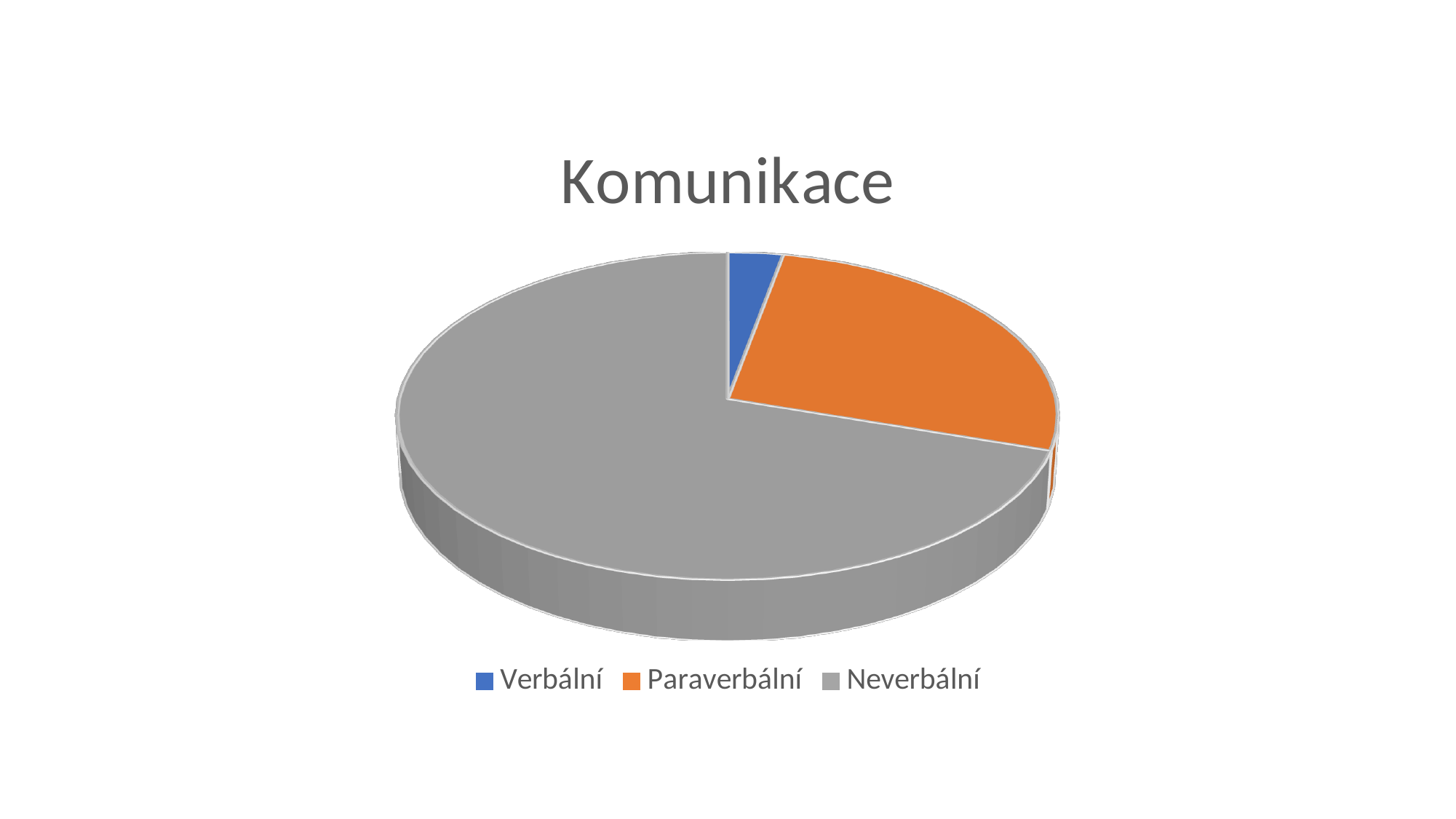
How many slices does the pie chart have? 3 Which category has the smallest slice of the pie? Verbální How many entries does the legend list? 3 Does the Neverbální slice take up more or less than half of the pie? more Which slice is larger, Paraverbální or Verbální? Paraverbální What kind of chart is shown on the slide? pie chart Which category has the largest slice of the pie? Neverbální What is the title of the chart? Komunikace Which slice is larger, Neverbální or Paraverbální? Neverbální Which colour represents Neverbální in the chart? grey